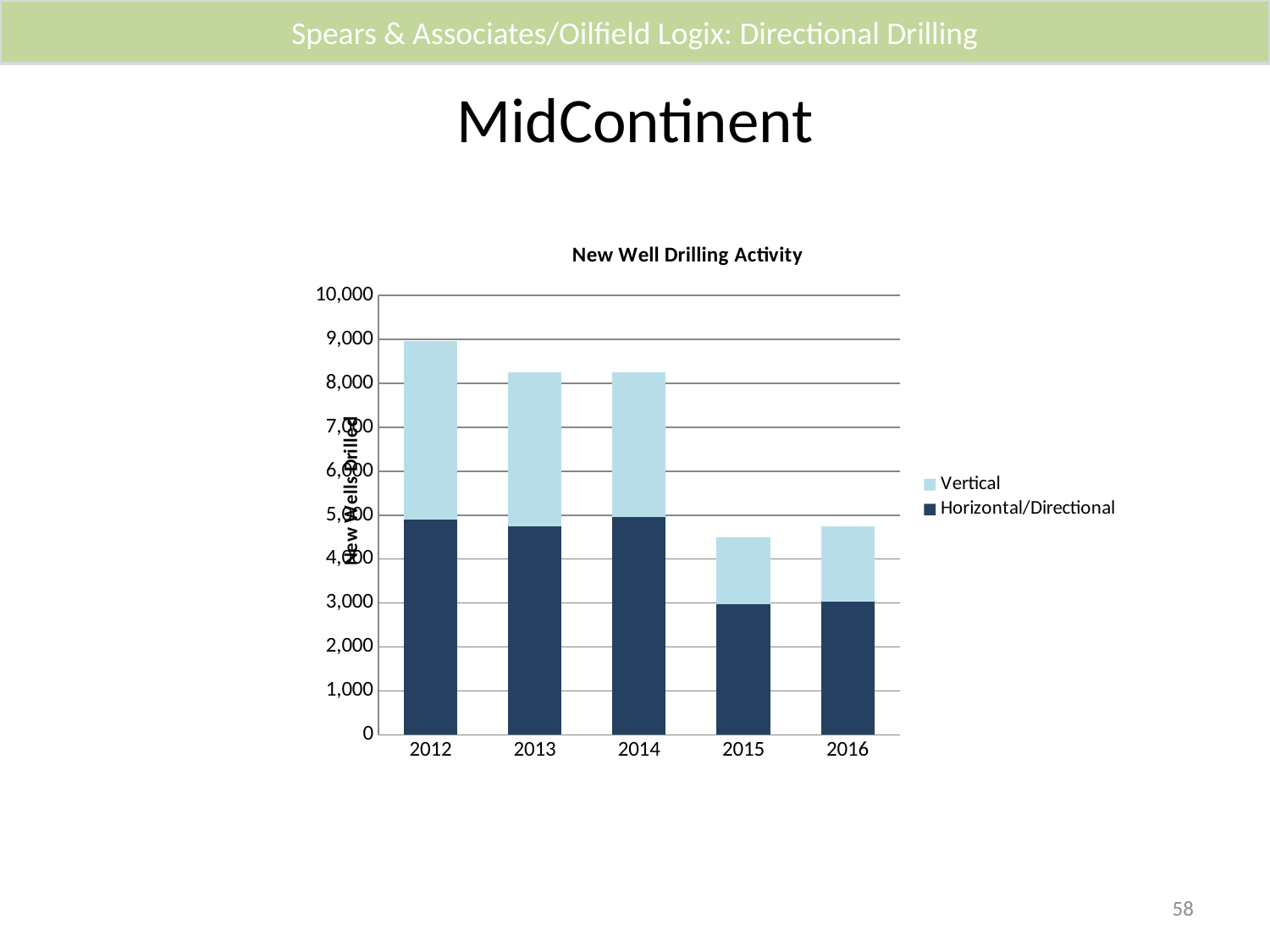
Is the total bar for 2015 greater or less than 5,000? less Which series is shown in the lighter blue colour? Vertical Is the Horizontal/Directional value for 2014 greater or less than 4,000? greater How many years are shown on the x axis? 5 Do the total bars generally rise or fall from 2012 to 2016? fall Is the total bar for 2012 greater or less than 8,000? greater What kind of chart is shown on the slide? Stacked bar chart Which year has a larger total bar, 2013 or 2016? 2013 What is the title of the chart? New Well Drilling Activity How many series does the legend list? 2 Which year has the highest total number of new wells drilled? 2012